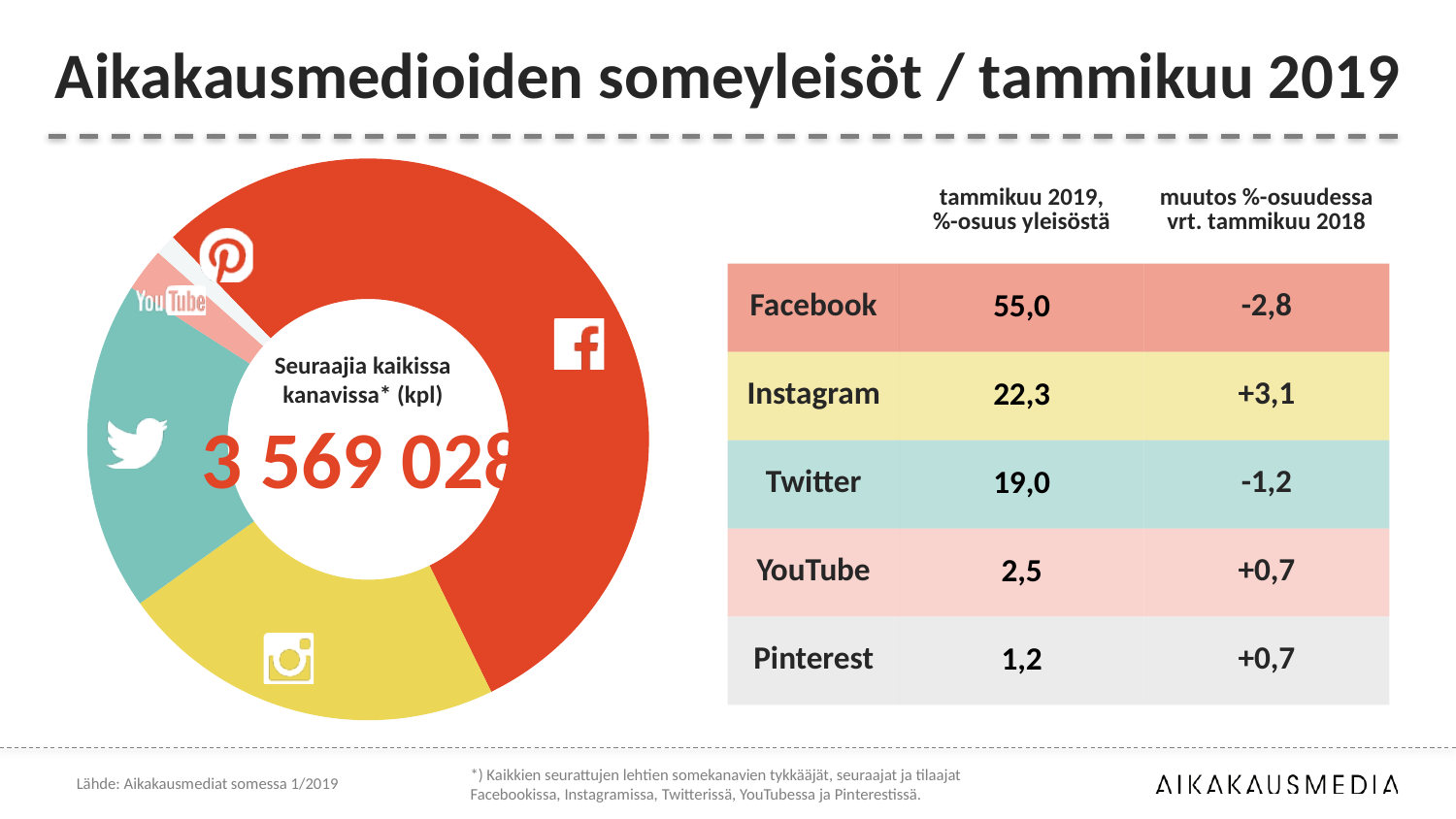
What is the change in Twitter's percentage share compared with January 2018? -1,2 What is the total number of followers across all channels shown in the centre of the donut chart? 3 569 028 How many channels are shown in the donut chart and table? 5 What is the title of the slide? Aikakausmedioiden someyleisöt / tammikuu 2019 Which channel had the largest increase in percentage share compared with January 2018? Instagram Which channel has the smallest share of the audience? Pinterest What is the difference between Facebook's and Instagram's percentage shares in January 2019? 32,7 What is Facebook's share of the audience in January 2019 according to the table? 55,0 Which has a larger share of the audience, Twitter or YouTube? Twitter What kind of chart is shown on the left of the slide? Donut (pie) chart Which channel has the largest share of the audience in the donut chart? Facebook What is Instagram's share of the audience in January 2019? 22,3